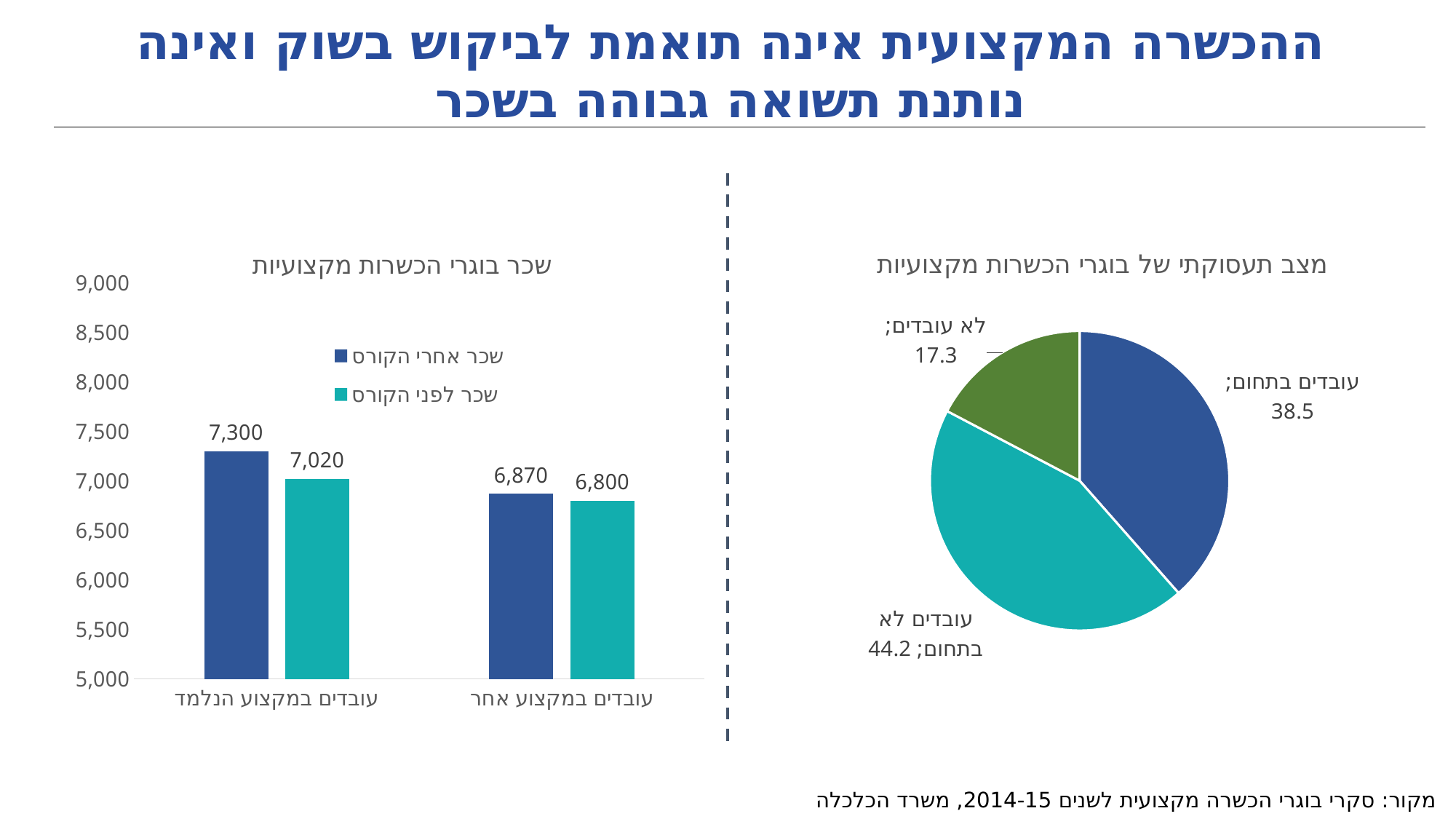
In the pie chart titled "מצב תעסוקתי של בוגרי הכשרות מקצועיות", which slice is the smallest? לא עובדים In the bar chart titled "שכר בוגרי הכשרות מקצועיות", what is the difference between "שכר אחרי הקורס" and "שכר לפני הקורס" for "עובדים במקצוע הנלמד"? 280 In the bar chart titled "שכר בוגרי הכשרות מקצועיות", what is the value of "שכר לפני הקורס" for "עובדים במקצוע הנלמד"? 7,020 In the pie chart titled "מצב תעסוקתי של בוגרי הכשרות מקצועיות", how many slices are there? 3 In the bar chart titled "שכר בוגרי הכשרות מקצועיות", what is the difference between "שכר אחרי הקורס" and "שכר לפני הקורס" for "עובדים במקצוע אחר"? 70 In the bar chart titled "שכר בוגרי הכשרות מקצועיות", what is the value of "שכר אחרי הקורס" for "עובדים במקצוע הנלמד"? 7,300 In the pie chart titled "מצב תעסוקתי של בוגרי הכשרות מקצועיות", what is the value for "עובדים לא בתחום"? 44.2 In the bar chart titled "שכר בוגרי הכשרות מקצועיות", what is the value of "שכר לפני הקורס" for "עובדים במקצוע אחר"? 6,800 What kind of chart is the chart on the left of the slide? Bar chart In the bar chart titled "שכר בוגרי הכשרות מקצועיות", how many series does the legend list? 2 In the bar chart titled "שכר בוגרי הכשרות מקצועיות", which bar has the highest value? שכר אחרי הקורס for עובדים במקצוע הנלמד (7,300) In the bar chart titled "שכר בוגרי הכשרות מקצועיות", which is larger: "שכר אחרי הקורס" for "עובדים במקצוע הנלמד" or "שכר אחרי הקורס" for "עובדים במקצוע אחר"? עובדים במקצוע הנלמד